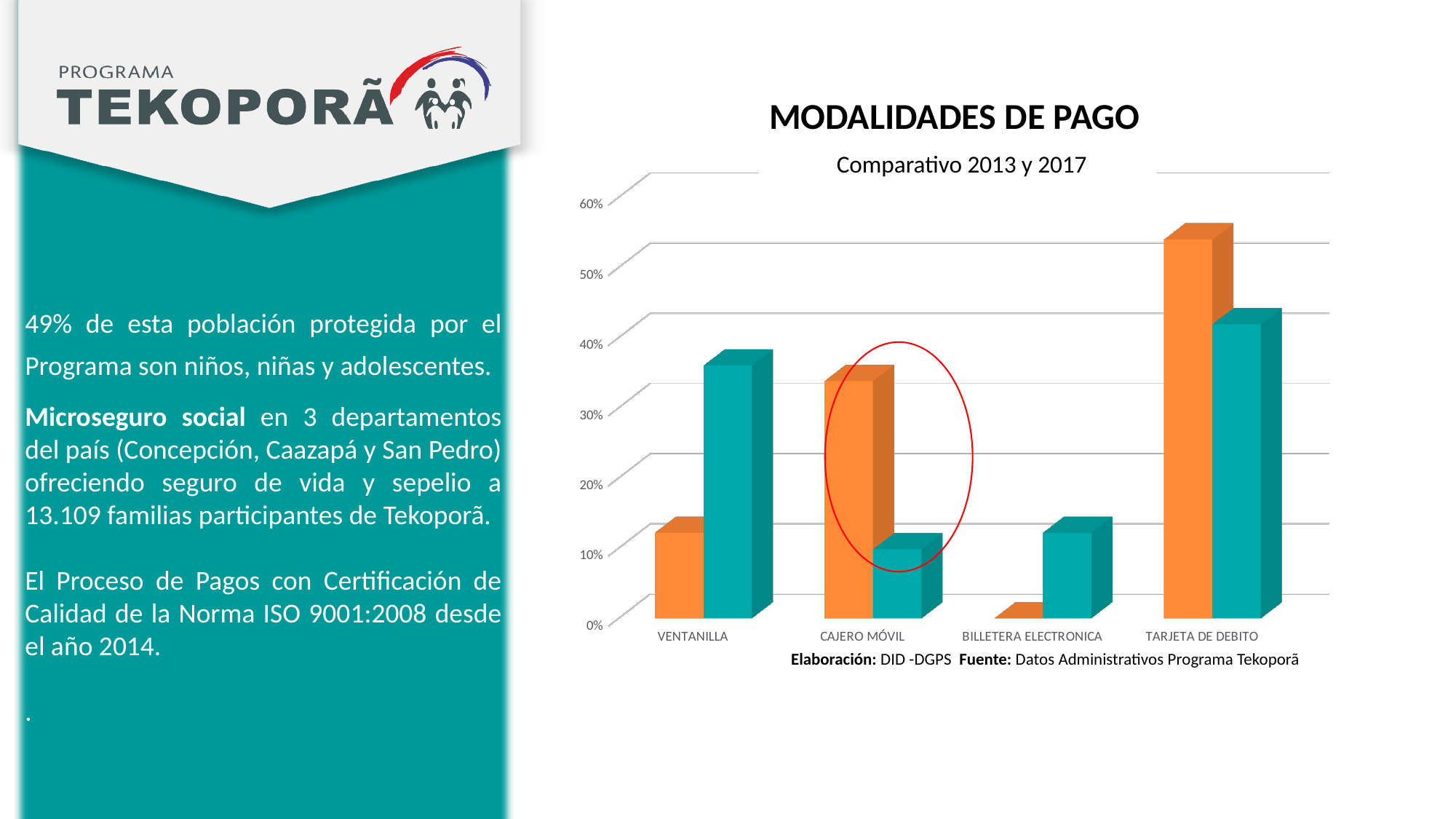
Is the teal bar for VENTANILLA greater or less than 30%? greater Among the orange bars, which category has the lowest value? BILLETERA ELECTRONICA What kind of chart is shown on the slide? bar chart How many payment categories are shown on the x axis of the chart? 4 What is the title of the chart? MODALIDADES DE PAGO Is the orange bar for TARJETA DE DEBITO greater or less than 50%? greater Among the orange bars, which category has the highest value? TARJETA DE DEBITO Among the teal bars, which category has the highest value? TARJETA DE DEBITO For VENTANILLA, which bar is larger, the orange one or the teal one? teal For CAJERO MÓVIL, which bar is larger, the orange one or the teal one? orange Which category on the chart is circled in red? CAJERO MÓVIL Is the orange bar for BILLETERA ELECTRONICA greater or less than 10%? less